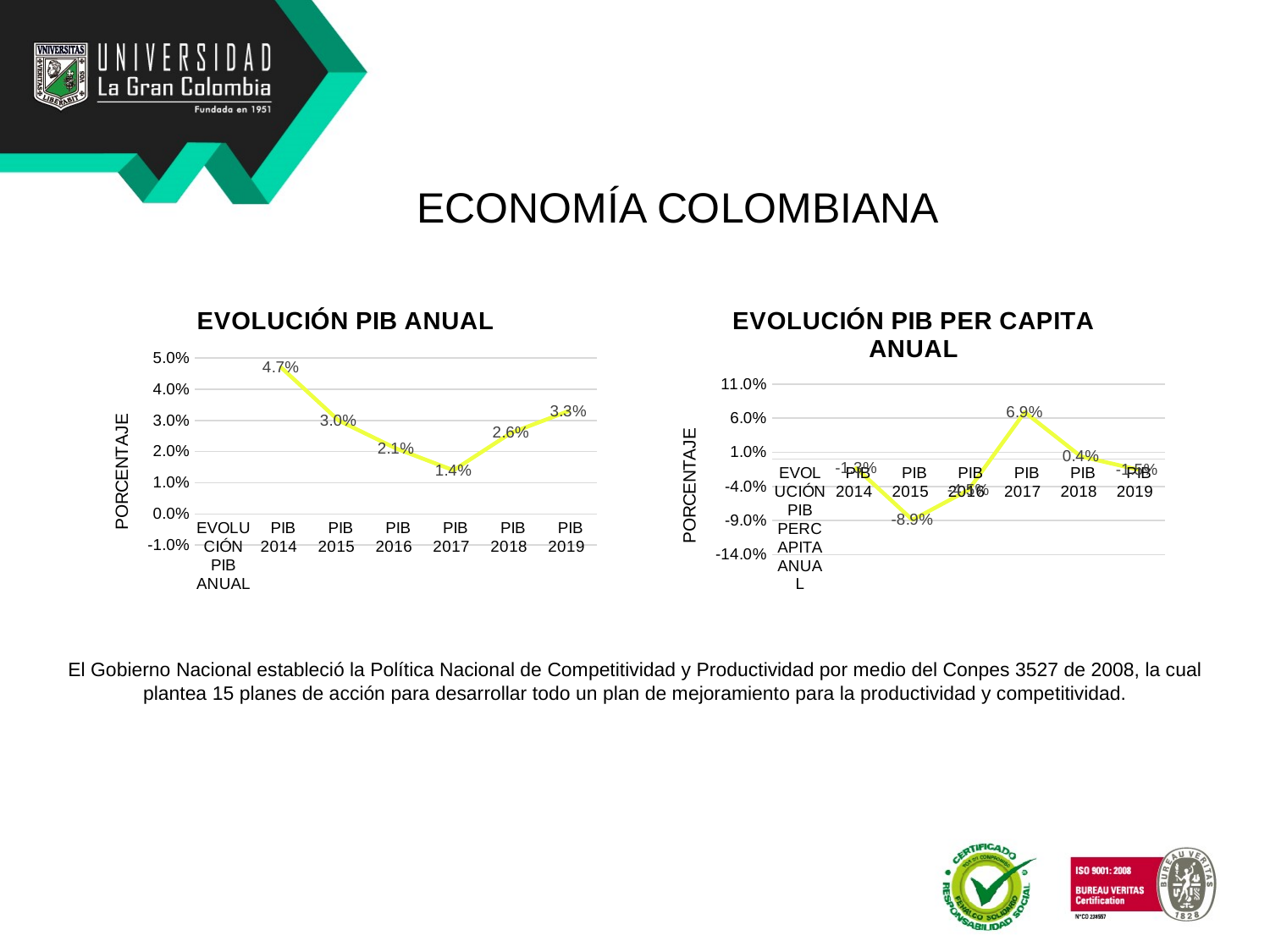
In the EVOLUCIÓN PIB PER CAPITA ANUAL chart, what is the value for PIB 2017? 6.9% In the EVOLUCIÓN PIB ANUAL chart, what is the value for PIB 2017? 1.4% What kind of chart is the EVOLUCIÓN PIB ANUAL chart? line chart What is the y-axis label of the EVOLUCIÓN PIB PER CAPITA ANUAL chart? PORCENTAJE In the EVOLUCIÓN PIB ANUAL chart, which year has the highest value? PIB 2014 In the EVOLUCIÓN PIB ANUAL chart, which is larger, the value for PIB 2018 or PIB 2019? PIB 2019 In the EVOLUCIÓN PIB PER CAPITA ANUAL chart, which year has the lowest value? PIB 2015 In the EVOLUCIÓN PIB ANUAL chart, what is the value for PIB 2014? 4.7% In the EVOLUCIÓN PIB ANUAL chart, which year has the lowest value? PIB 2017 In the EVOLUCIÓN PIB ANUAL chart, what is the difference between the values for PIB 2014 and PIB 2015? 1.7% In the EVOLUCIÓN PIB ANUAL chart, do the values rise or fall from PIB 2014 to PIB 2017? fall In the EVOLUCIÓN PIB PER CAPITA ANUAL chart, what is the value for PIB 2015? -8.9%